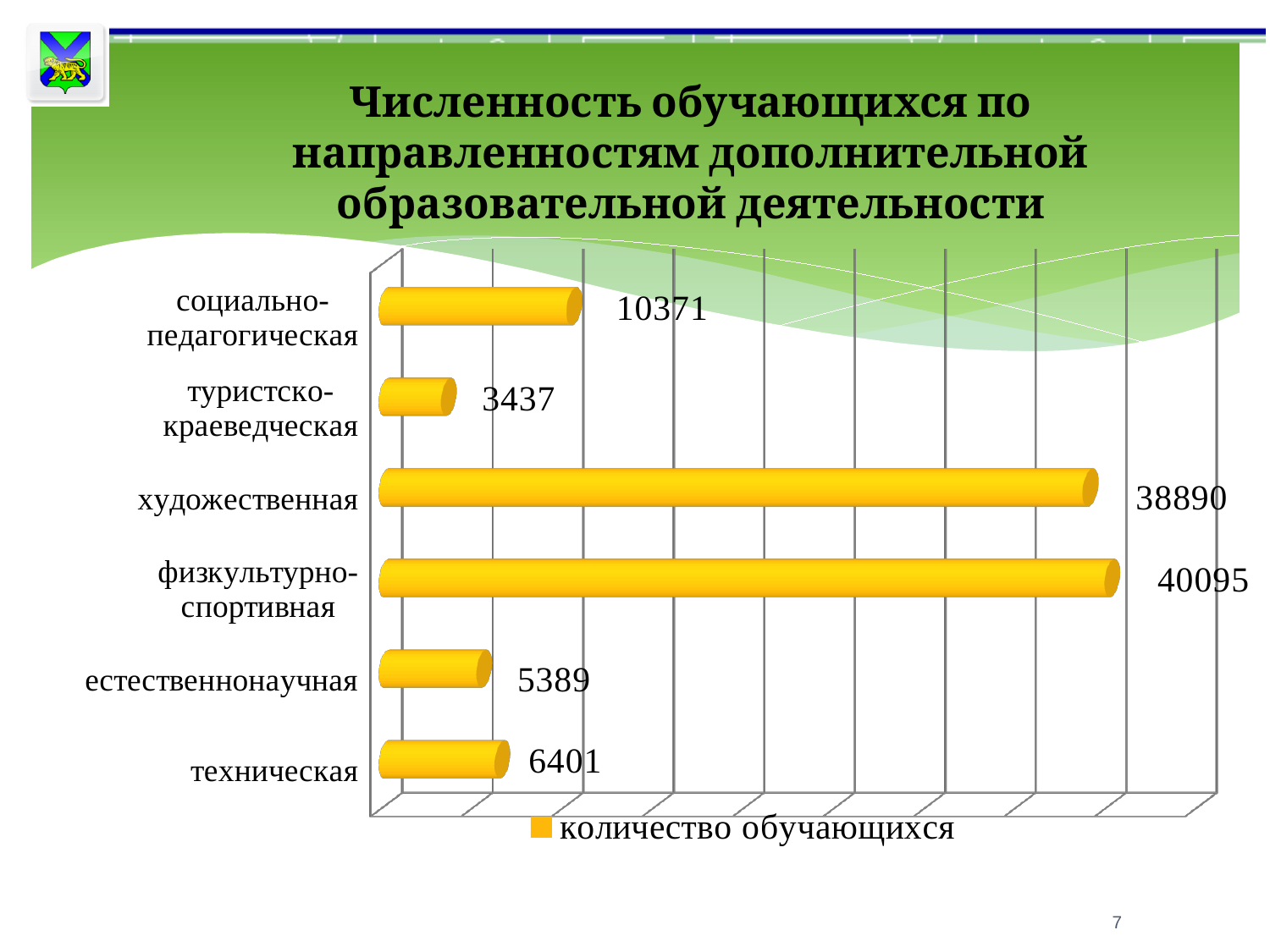
What is the value shown for туристско-краеведческая? 3437 What is the value shown for техническая? 6401 How many directions (categories) are shown in the chart? 6 What is the difference between социально-педагогическая and естественнонаучная? 4982 Which direction has the highest number of students? физкультурно-спортивная How many series does the legend list? 1 What is the difference between физкультурно-спортивная and художественная? 1205 What kind of chart is shown on the slide? bar chart What is the number of students for the художественная direction? 38890 Which direction has the lowest number of students? туристско-краеведческая What is the legend entry of the chart? количество обучающихся Which is larger, техническая or естественнонаучная? техническая